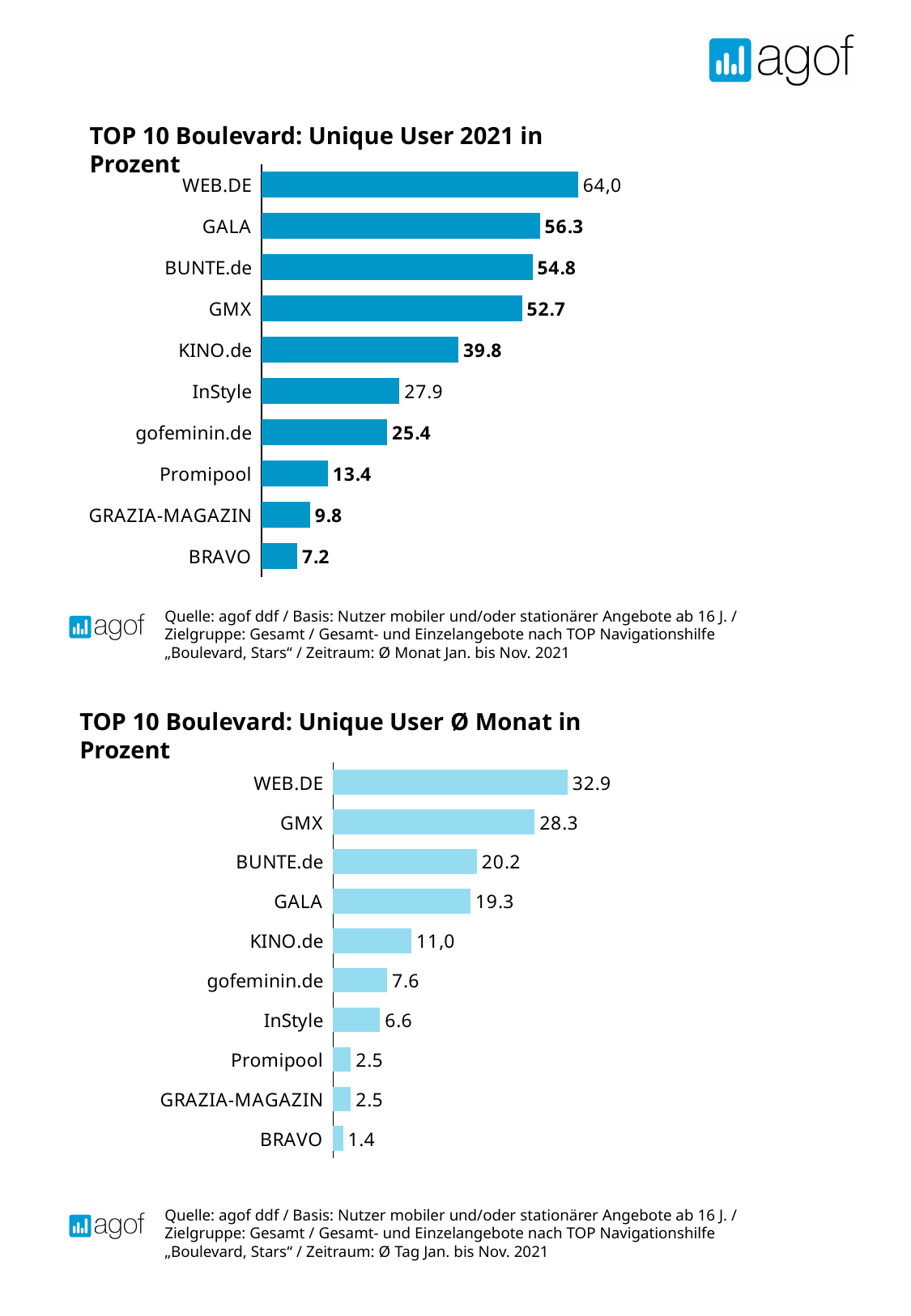
In the chart 'TOP 10 Boulevard: Unique User Ø Monat in Prozent', which is larger, the value for gofeminin.de or the value for InStyle? gofeminin.de In the chart 'TOP 10 Boulevard: Unique User 2021 in Prozent', what is the difference between the values for KINO.de and InStyle? 11.9 What kind of chart is 'TOP 10 Boulevard: Unique User Ø Monat in Prozent'? Bar chart In the chart 'TOP 10 Boulevard: Unique User 2021 in Prozent', what is the value for WEB.DE? 64,0 In the chart 'TOP 10 Boulevard: Unique User 2021 in Prozent', which category has the lowest value? BRAVO In the chart 'TOP 10 Boulevard: Unique User 2021 in Prozent', what is the value for GALA? 56.3 In the chart 'TOP 10 Boulevard: Unique User Ø Monat in Prozent', what is the value for KINO.de? 11,0 In the chart 'TOP 10 Boulevard: Unique User Ø Monat in Prozent', what is the value for GMX? 28.3 In the chart 'TOP 10 Boulevard: Unique User Ø Monat in Prozent', which category has the highest value? WEB.DE In the chart 'TOP 10 Boulevard: Unique User 2021 in Prozent', which is larger, the value for Promipool or the value for GRAZIA-MAGAZIN? Promipool In the chart 'TOP 10 Boulevard: Unique User Ø Monat in Prozent', what is the difference between the values for BUNTE.de and GALA? 0.9 In the chart 'TOP 10 Boulevard: Unique User 2021 in Prozent', how many categories are shown? 10